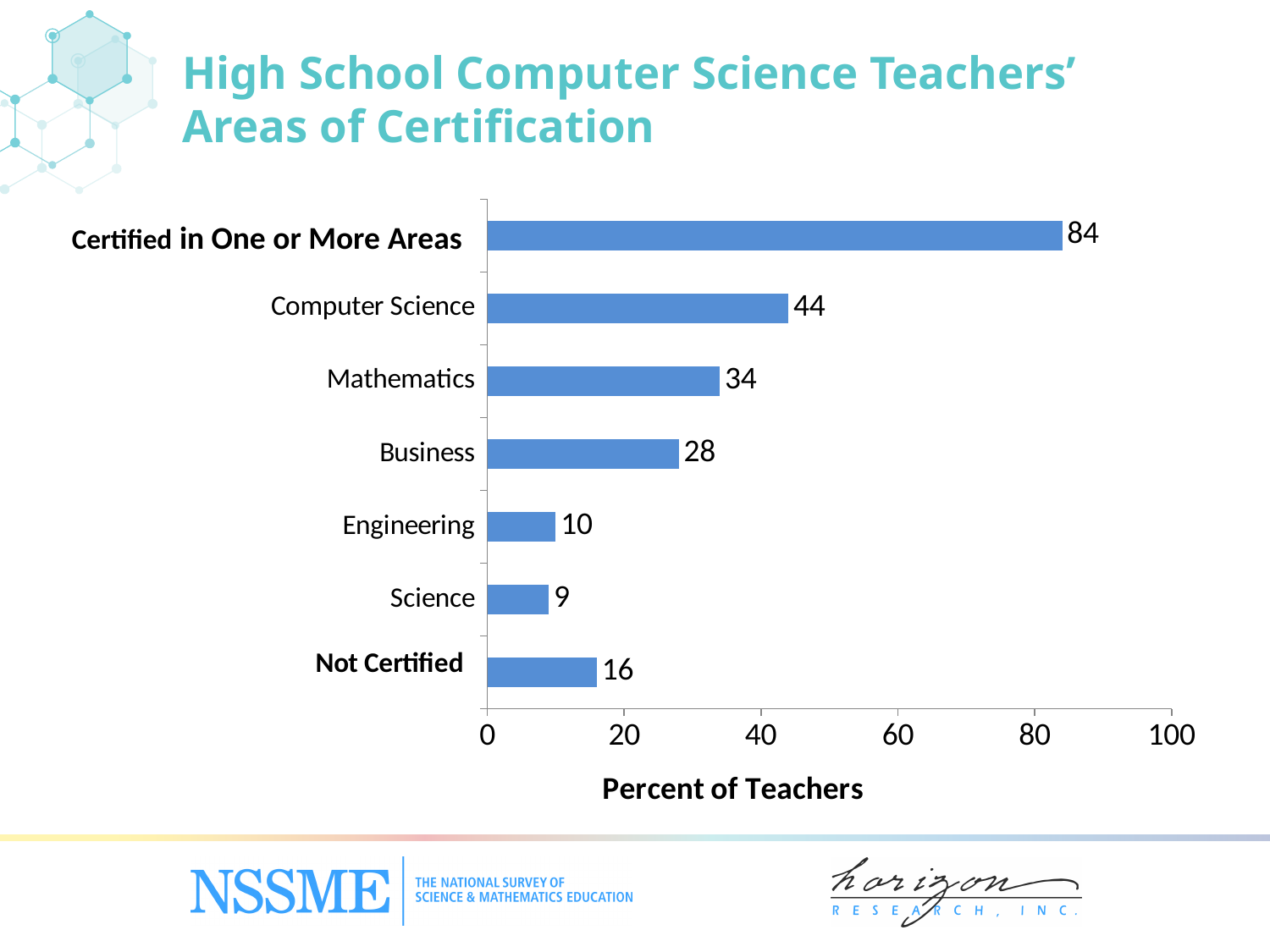
What is the label of the horizontal axis? Percent of Teachers Which is larger, the value for Business or the value for Engineering? Business Is the value for Certified in One or More Areas greater or less than 80? greater What percent of teachers are Not Certified? 16 What is the difference between the values for Engineering and Science? 1 What percent of teachers are certified in Computer Science? 44 Which category has the lowest value? Science How many categories are shown in the chart? 7 What is the difference between the values for Computer Science and Mathematics? 10 What is the value for Mathematics? 34 Which category has the highest value? Certified in One or More Areas What kind of chart is shown on the slide? bar chart